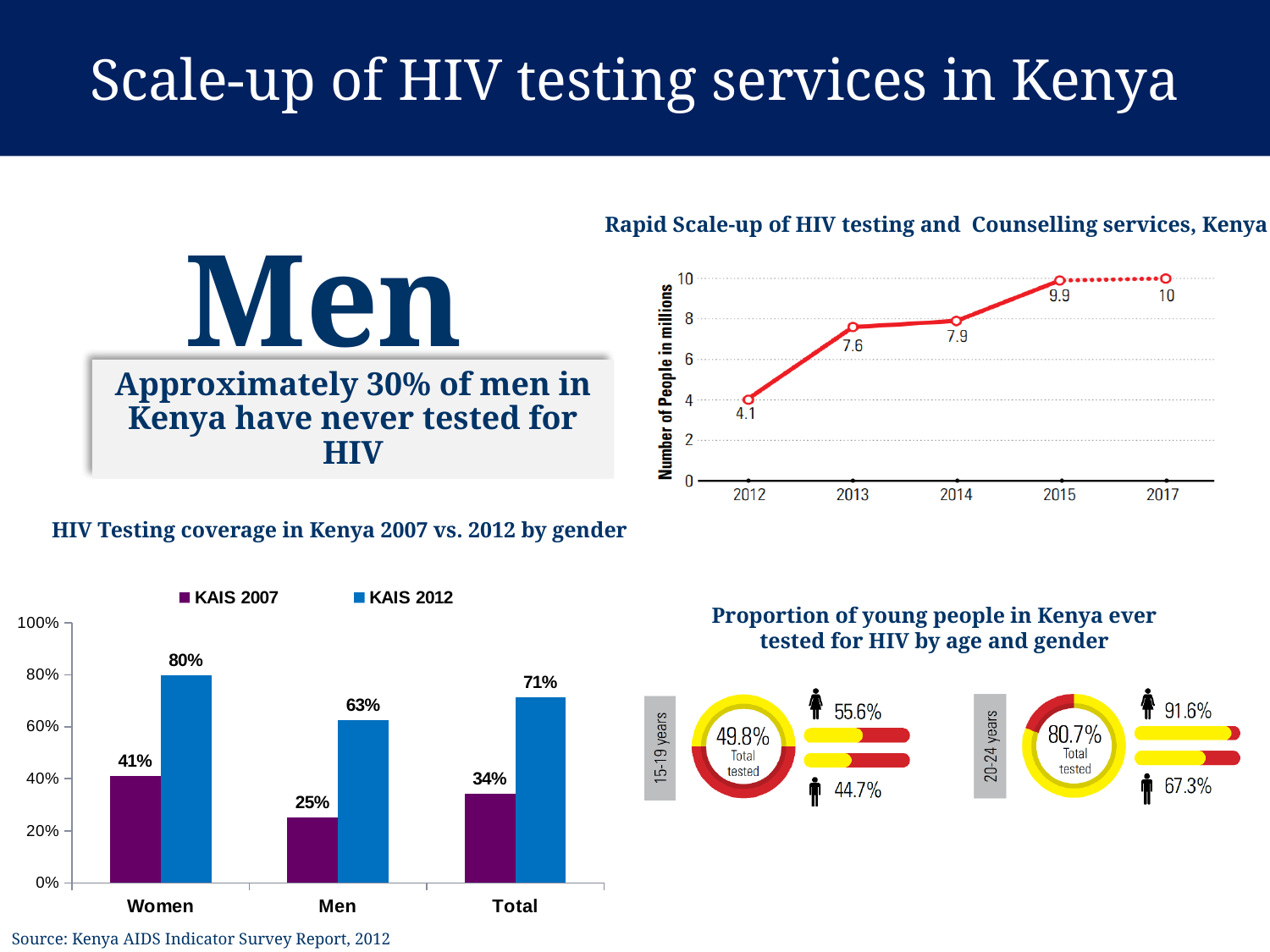
In the 'HIV Testing coverage in Kenya 2007 vs. 2012 by gender' bar chart, how many series does the legend list? 2 In the 'HIV Testing coverage in Kenya 2007 vs. 2012 by gender' bar chart, what is the KAIS 2007 value for Men? 25% In the 'Rapid Scale-up of HIV testing and Counselling services, Kenya' line chart, what is the difference between the 2015 and 2012 values? 5.8 In the 'Rapid Scale-up of HIV testing and Counselling services, Kenya' line chart, what is the number of people tested (in millions) in 2013? 7.6 In the 'Proportion of young people in Kenya ever tested for HIV by age and gender' graphic, which is larger for the 15-19 years group: the female value or the male value? Female (55.6%) In the 'HIV Testing coverage in Kenya 2007 vs. 2012 by gender' bar chart, how many categories are shown on the x axis? 3 In the 'Proportion of young people in Kenya ever tested for HIV by age and gender' graphic, what is the total tested for the 20-24 years group? 80.7% In the 'HIV Testing coverage in Kenya 2007 vs. 2012 by gender' bar chart, what is the difference between the KAIS 2012 and KAIS 2007 values for Total? 37% In the 'HIV Testing coverage in Kenya 2007 vs. 2012 by gender' bar chart, which category has the lowest KAIS 2007 value? Men In the 'HIV Testing coverage in Kenya 2007 vs. 2012 by gender' bar chart, what is the KAIS 2012 value for Women? 80% What kind of chart is 'HIV Testing coverage in Kenya 2007 vs. 2012 by gender'? Bar chart In the 'Rapid Scale-up of HIV testing and Counselling services, Kenya' line chart, do the values rise or fall from 2012 to 2017? Rise